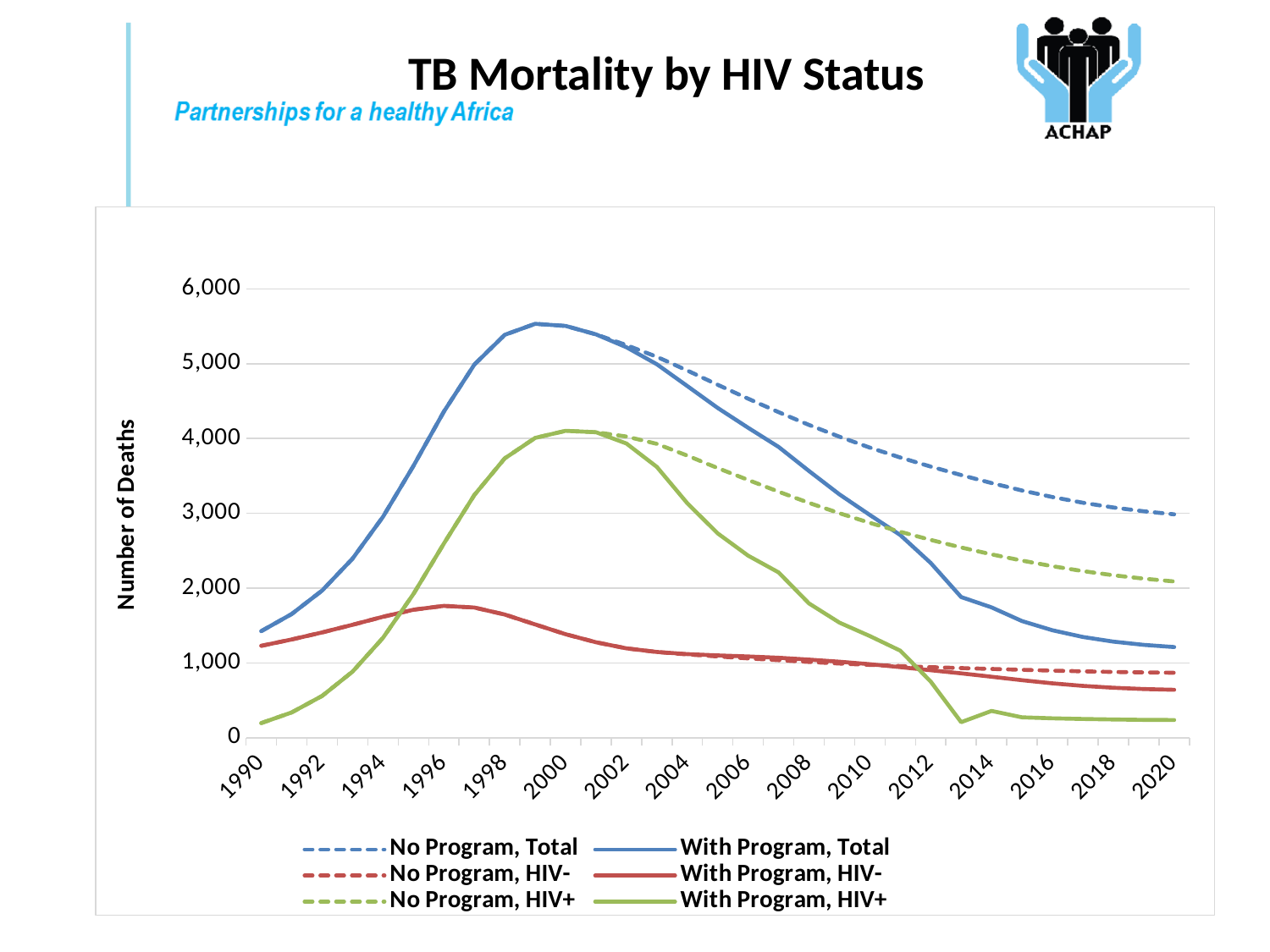
How many year labels are shown on the x axis? 16 What kind of chart is shown on the slide? line chart Is the value for No Program, Total in 2020 greater or less than 2,000? greater Is the value for With Program, Total in 2000 greater or less than 5,000? greater How many series does the legend list? 6 Does the With Program, HIV+ line rise or fall between 2002 and 2014? fall What is the title of the chart? TB Mortality by HIV Status What is the label on the vertical axis? Number of Deaths Is the value for With Program, HIV- in 2020 greater or less than 1,000? less In 1990, which is higher: With Program, HIV- or With Program, HIV+? With Program, HIV- In 2020, which is higher: No Program, Total or With Program, Total? No Program, Total